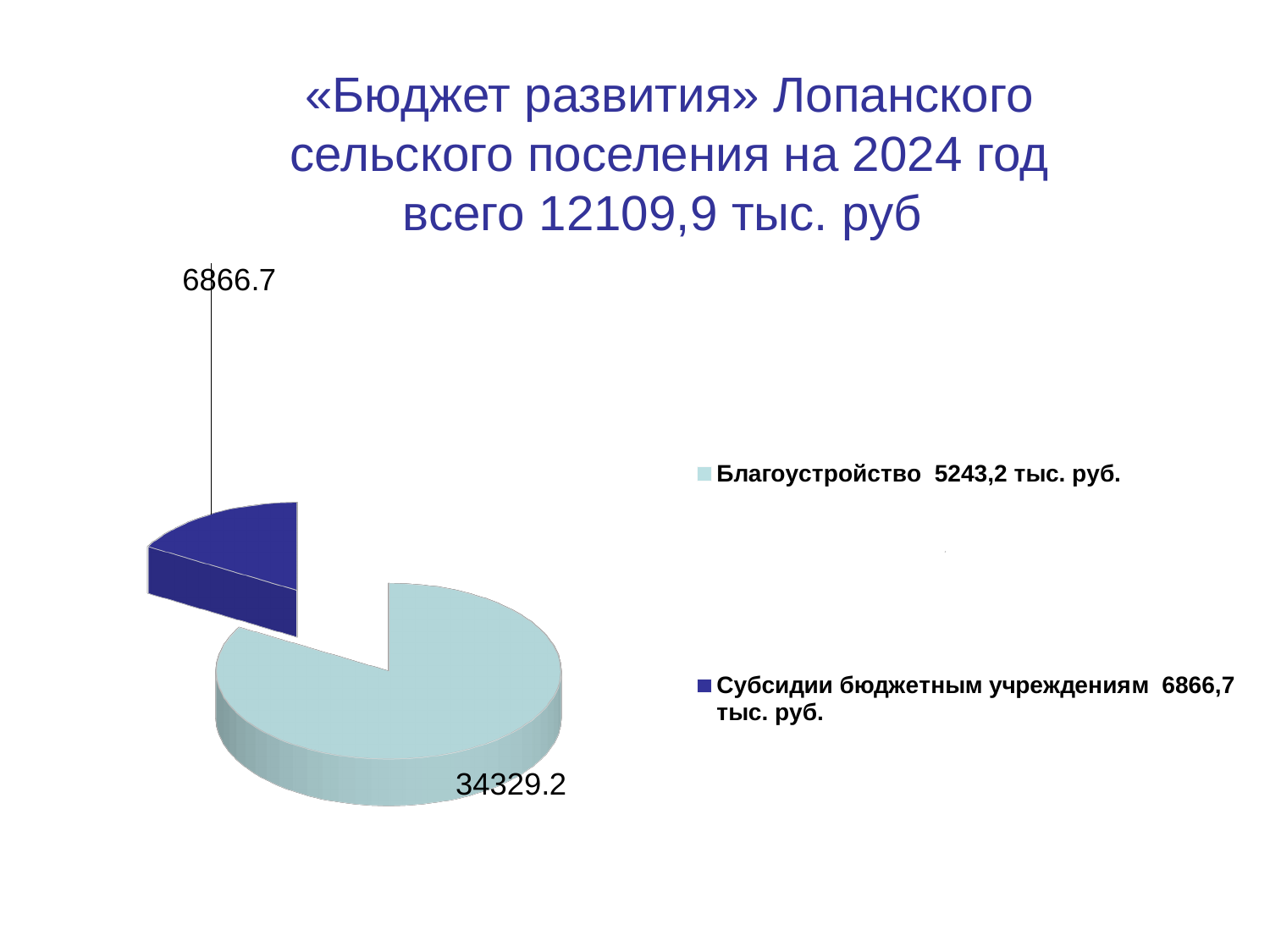
What colour is the Субсидии бюджетным учреждениям slice? dark blue What value does the legend give for Благоустройство? 5243,2 тыс. руб. How many entries does the legend list? 2 What data label is shown on the Субсидии бюджетным учреждениям slice? 6866.7 What total amount is stated in the slide title? 12109,9 тыс. руб Which category has the largest slice of the pie? Благоустройство Which category has the smallest slice of the pie? Субсидии бюджетным учреждениям What data label is shown on the Благоустройство slice? 34329.2 Which slice is larger, Благоустройство or Субсидии бюджетным учреждениям? Благоустройство What value does the legend give for Субсидии бюджетным учреждениям? 6866,7 тыс. руб. What kind of chart is shown on the slide? pie chart How many slices does the pie chart have? 2